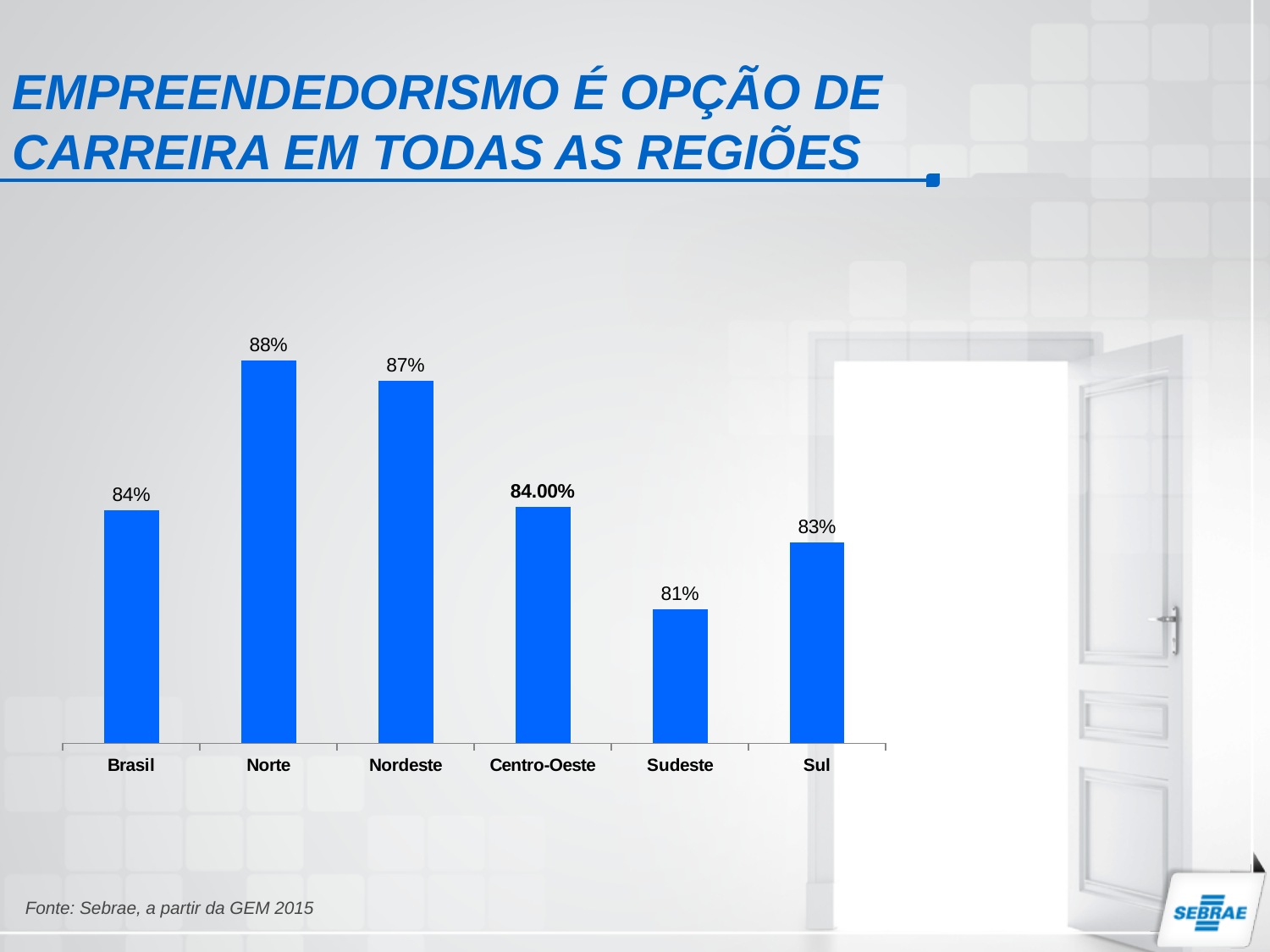
What is the value for Sudeste? 81% How many categories are shown on the x axis? 6 What is the value for Centro-Oeste? 84.00% What source is cited below the chart? Sebrae, a partir da GEM 2015 What is the difference between the values for Norte and Sudeste? 7% What kind of chart is shown on the slide? Bar chart Which is larger, the value for Brasil or the value for Sul? Brasil What is the value for Norte? 88% What is the difference between the values for Nordeste and Sul? 4% Which category has the highest value? Norte What is the value for Sul? 83% Which category has the lowest value? Sudeste